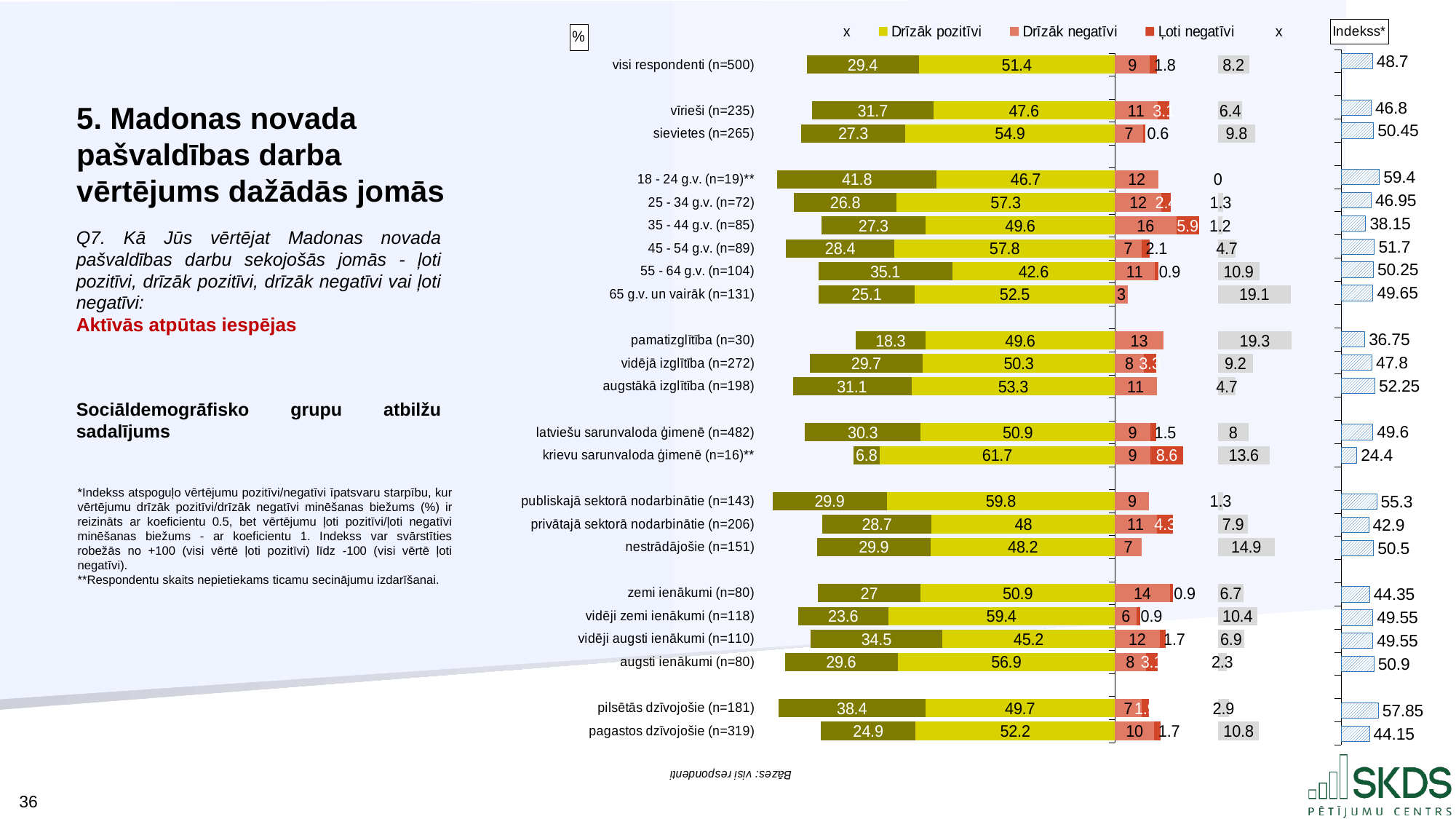
Which area of municipal work is evaluated in this chart, as shown in the red subtitle? Aktīvās atpūtas iespējas Which group has the highest Indekss value? 18 - 24 g.v. (n=19)** What is the Drīzāk pozitīvi value for visi respondenti (n=500)? 51.4 Which has a larger Drīzāk pozitīvi value, vīrieši (n=235) or sievietes (n=265)? sievietes (n=265) What is the difference between the Drīzāk pozitīvi values for publiskajā sektorā nodarbinātie (n=143) and privātajā sektorā nodarbinātie (n=206)? 11.8 What kind of chart is used to show the response shares? bar chart What is the Drīzāk negatīvi value for 35 - 44 g.v. (n=85)? 16 Which group has the lowest Indekss value? krievu sarunvaloda ģimenē (n=16)** What is the difference between the Indekss values for sievietes (n=265) and vīrieši (n=235)? 3.65 How many respondent groups (bars) are shown in the chart? 23 What is the Indekss value for pilsētās dzīvojošie (n=181)? 57.85 What is the Drīzāk pozitīvi value for krievu sarunvaloda ģimenē (n=16)? 61.7